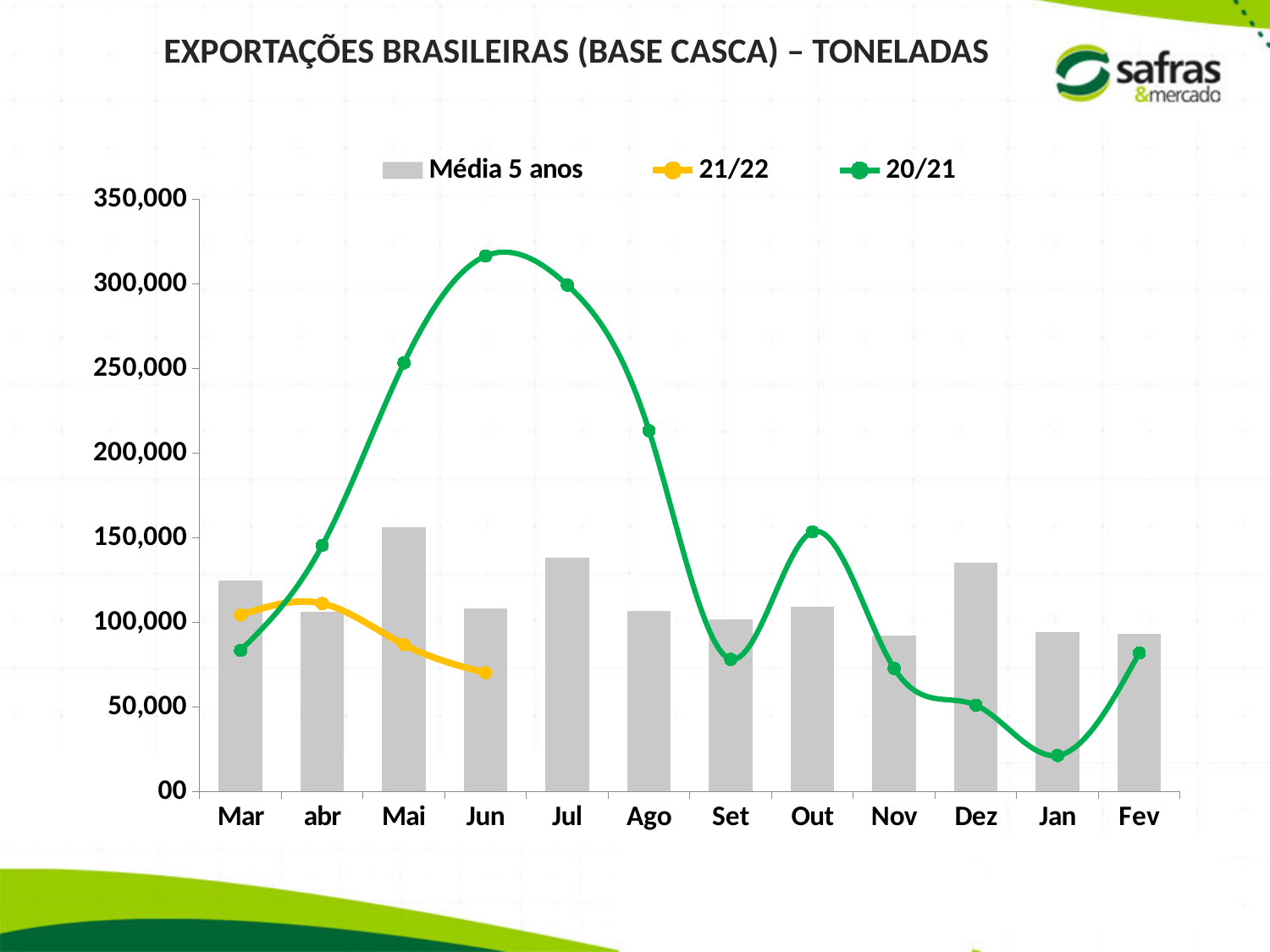
Which month has the tallest Média 5 anos bar? Mai Is the 20/21 value for Jun greater or less than 300,000? greater How many months are shown on the x axis? 12 Does the 21/22 series rise or fall from abr to Jun? It falls What kind of chart is shown on the slide? A combined bar and line chart How many series does the legend list? 3 In which month does the 20/21 series reach its highest value? Jun What is the title of the chart? EXPORTAÇÕES BRASILEIRAS (BASE CASCA) – TONELADAS In Mai, which is larger: the 20/21 value or the Média 5 anos value? 20/21 In which month does the 20/21 series reach its lowest value? Jan Is the Média 5 anos value for Dez greater or less than 150,000? less Is the 20/21 value for Jan greater or less than 50,000? less